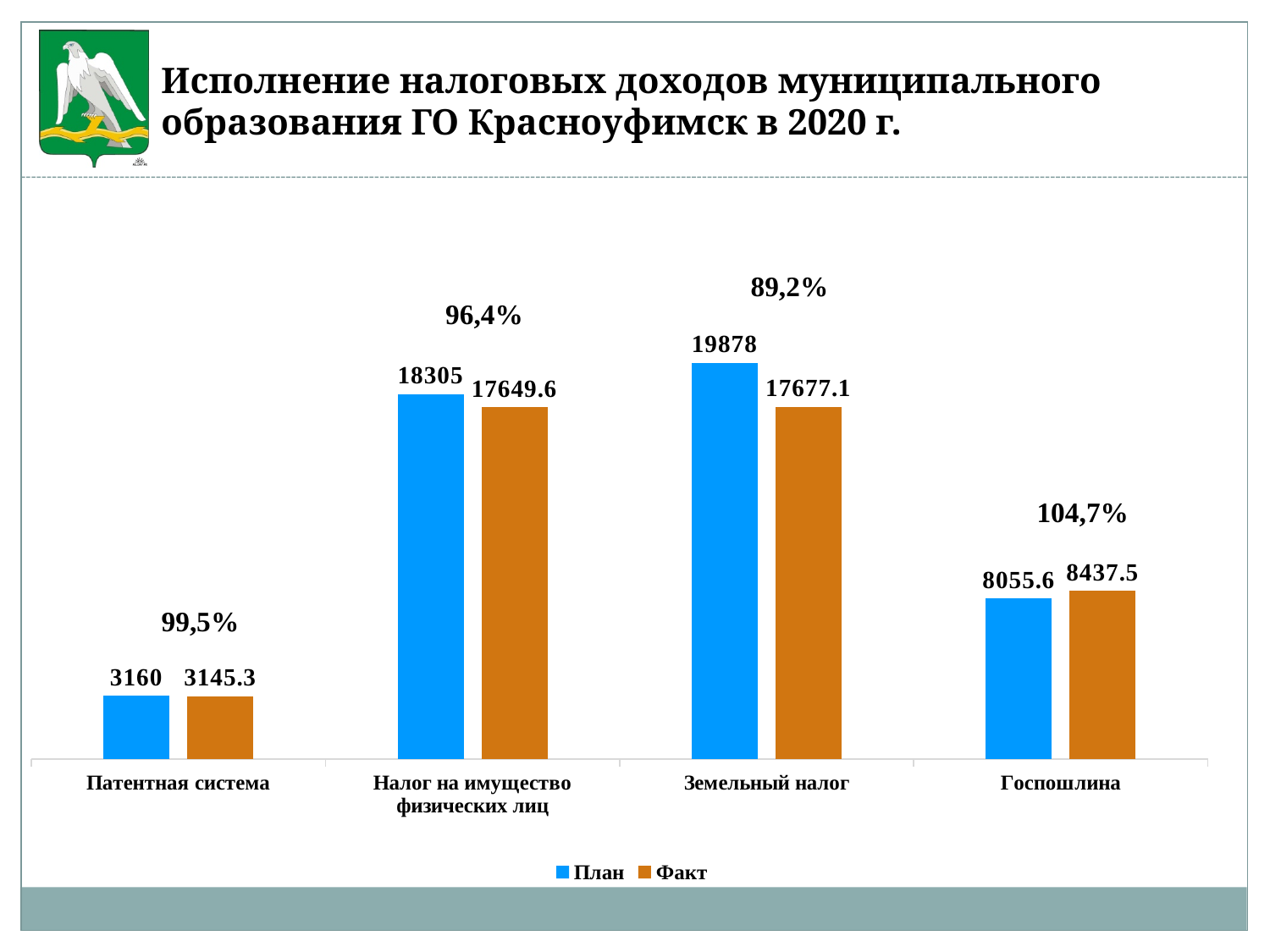
For Госпошлина, which is larger: the План value or the Факт value? Факт How many series does the legend list? 2 Which category has the highest План value? Земельный налог What percentage is shown above the Госпошлина bars? 104,7% What is the Факт value for Налог на имущество физических лиц? 17649.6 How many categories are shown on the x axis? 4 What is the difference between the План and Факт values for Земельный налог? 2200.9 What is the План value for Земельный налог? 19878 What is the difference between the Факт and План values for Госпошлина? 381.9 Which category has the lowest Факт value? Патентная система What kind of chart is shown on the slide? Bar chart What is the Факт value for Патентная система? 3145.3